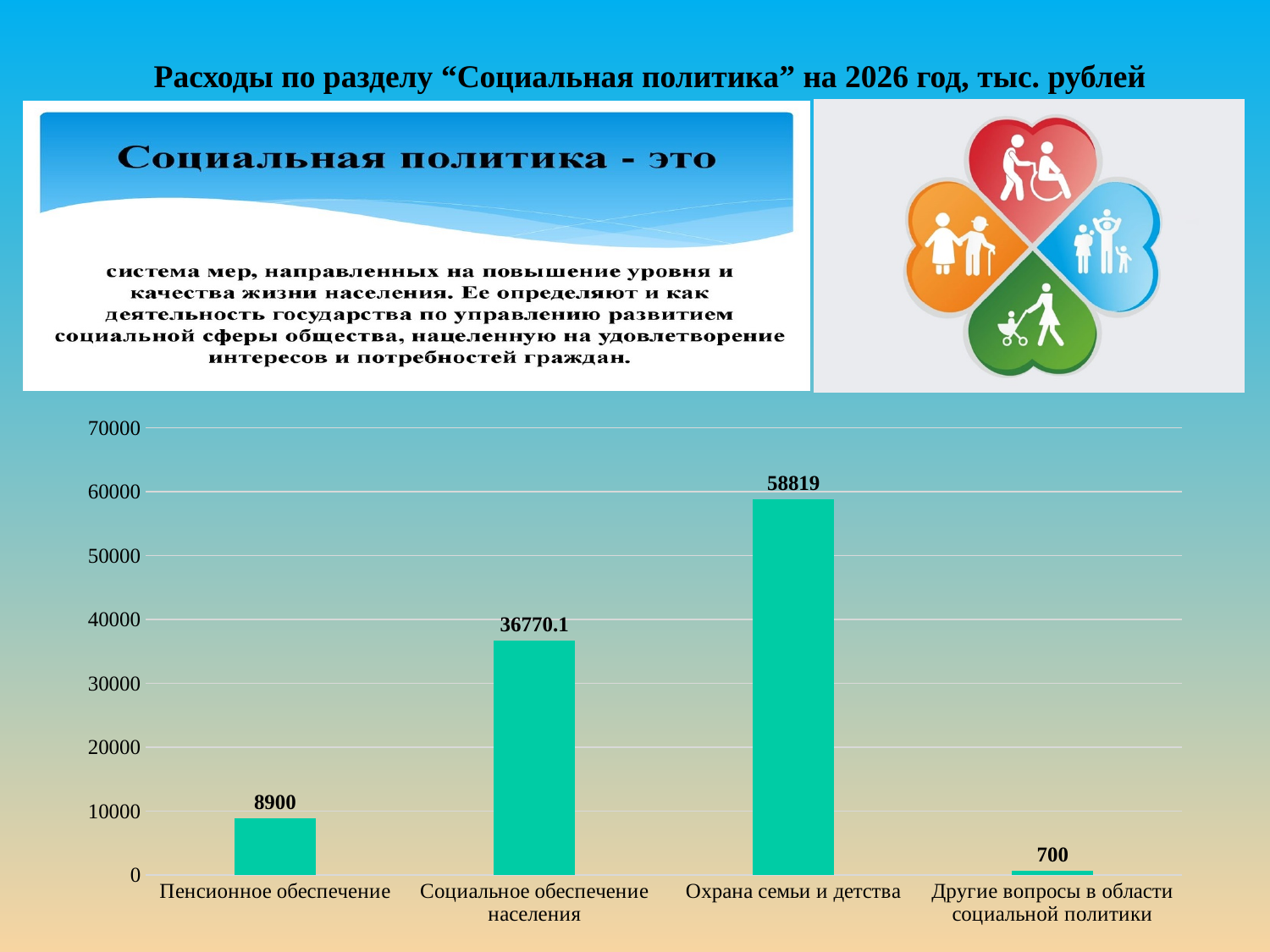
What is the value for Другие вопросы в области социальной политики? 700 What is the value for Социальное обеспечение населения? 36770.1 Which is larger: the value for Пенсионное обеспечение or the value for Социальное обеспечение населения? Социальное обеспечение населения Which category has the highest value? Охрана семьи и детства Which category has the lowest value? Другие вопросы в области социальной политики Is the value for Охрана семьи и детства greater or less than 50000? greater What is the value for Пенсионное обеспечение? 8900 What kind of chart is shown on the slide? bar chart What is the difference between the values for Пенсионное обеспечение and Другие вопросы в области социальной политики? 8200 What is the difference between the values for Охрана семьи и детства and Социальное обеспечение населения? 22048.9 What is the value for Охрана семьи и детства? 58819 How many categories are shown in the chart? 4